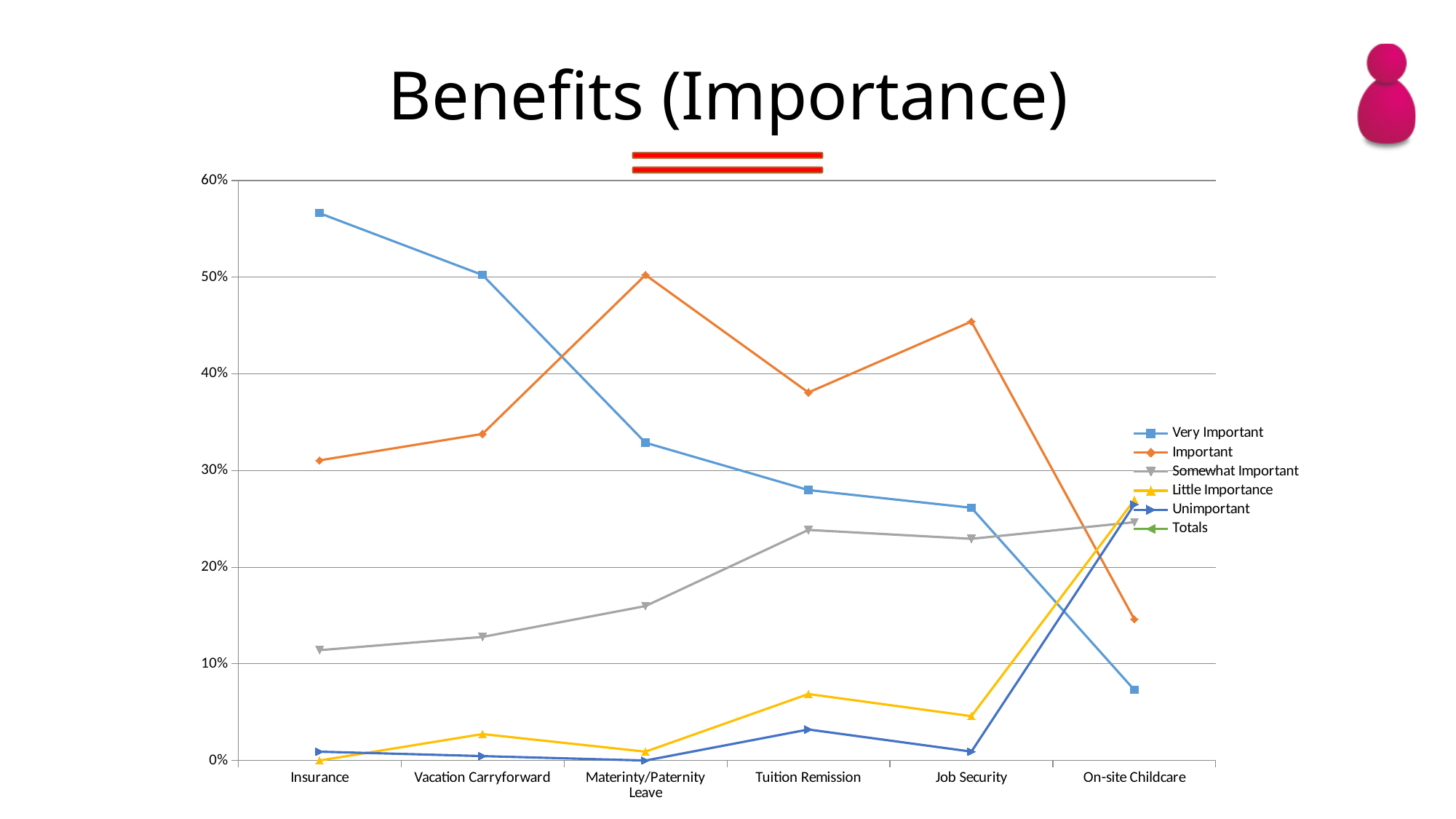
Is the Very Important value for Insurance greater or less than 50%? greater For On-site Childcare, which is larger: the Important value or the Very Important value? Important Is the Important value for Tuition Remission greater or less than 40%? less Does the Somewhat Important series generally rise or fall from Insurance to On-site Childcare? rise How many benefit categories are shown along the x axis? 6 What kind of chart is shown on the slide? line chart For which benefit is the Very Important series lowest? On-site Childcare For which benefit is the Important series highest? Materinty/Paternity Leave For Insurance, which is larger: the Very Important value or the Important value? Very Important How many series does the legend list? 6 For which benefit is the Very Important series highest? Insurance For which benefit is the Little Importance series highest? On-site Childcare